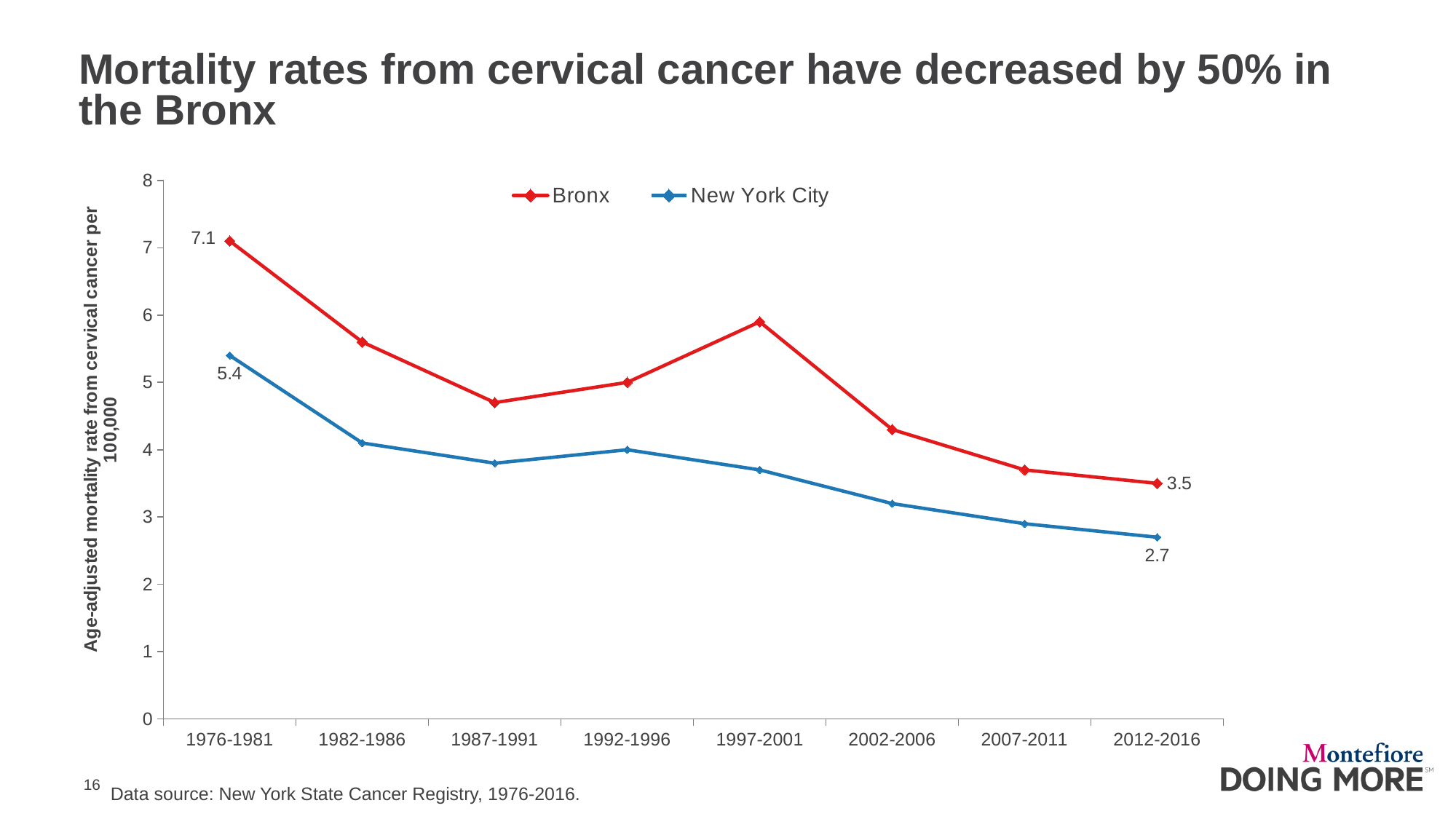
Is the Bronx value for 1997-2001 greater or less than 5? greater What was the Bronx cervical cancer mortality rate in 1976-1981? 7.1 What kind of chart is shown on the slide? line chart How many series does the legend list? 2 How many time periods are shown on the x axis? 8 By how much did the Bronx mortality rate fall from 1976-1981 to 2012-2016? 3.6 In 1976-1981, how much higher was the Bronx rate than the New York City rate? 1.7 What was the New York City cervical cancer mortality rate in 2012-2016? 2.7 What was the Bronx cervical cancer mortality rate in 2012-2016? 3.5 Is the New York City value for 1987-1991 greater or less than 4? less What was the New York City cervical cancer mortality rate in 1976-1981? 5.4 In 2012-2016, which had the higher mortality rate, the Bronx or New York City? Bronx